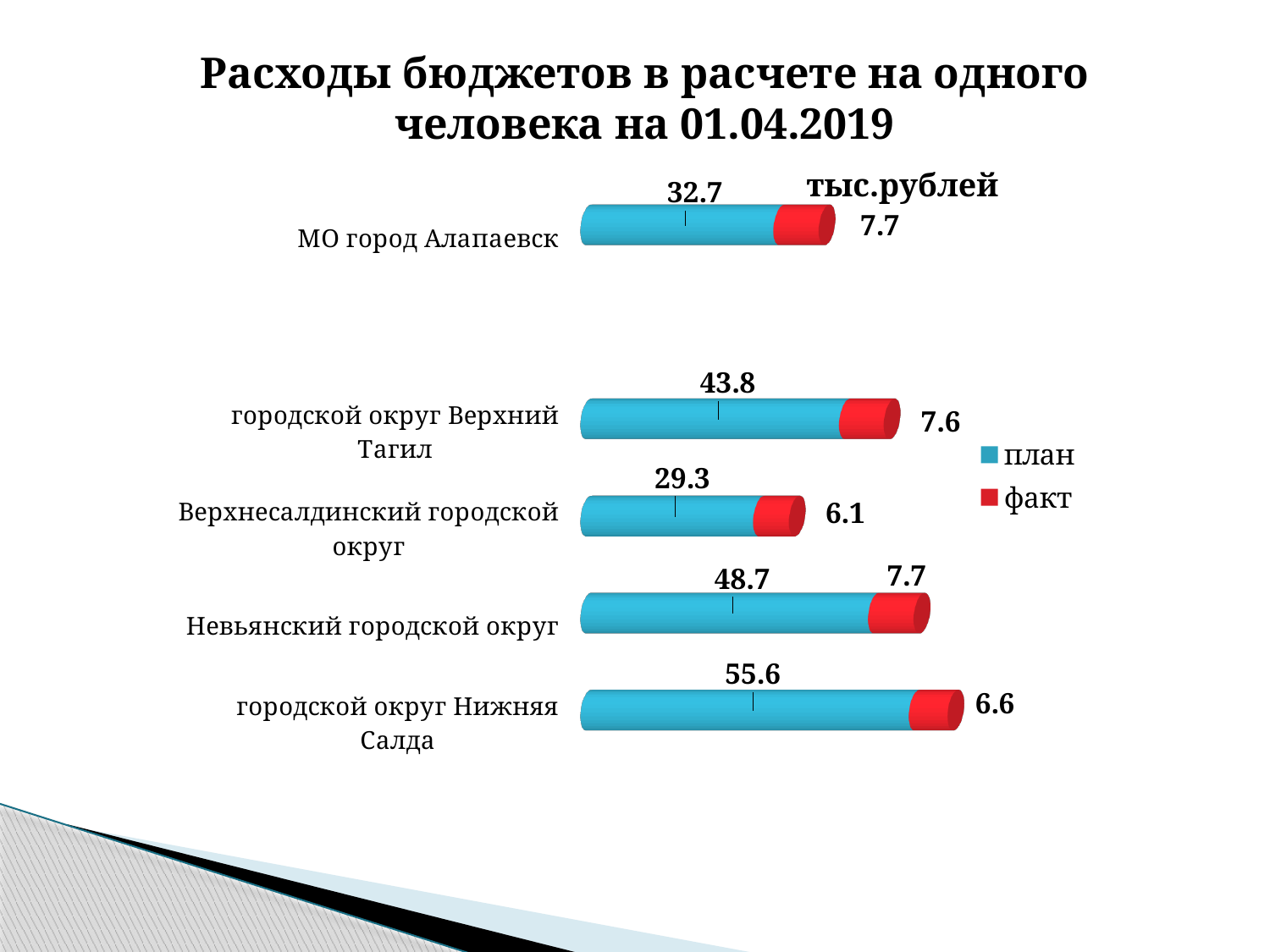
What is the difference between the план values of Невьянский городской округ and городской округ Верхний Тагил? 4.9 What is the план value for МО город Алапаевск? 32.7 What is the план value for городской округ Нижняя Салда? 55.6 How many series does the legend list? 2 What is the факт value for Верхнесалдинский городской округ? 6.1 What kind of chart is shown on the slide? Bar chart Which category has the highest план value? городской округ Нижняя Салда Which is larger, the факт value for городской округ Верхний Тагил or for городской округ Нижняя Салда? городской округ Верхний Тагил What is the total of the stacked bar for Невьянский городской округ? 56.4 Which category has the lowest план value? Верхнесалдинский городской округ Which category has the lowest факт value? Верхнесалдинский городской округ How many categories are shown in the chart? 5